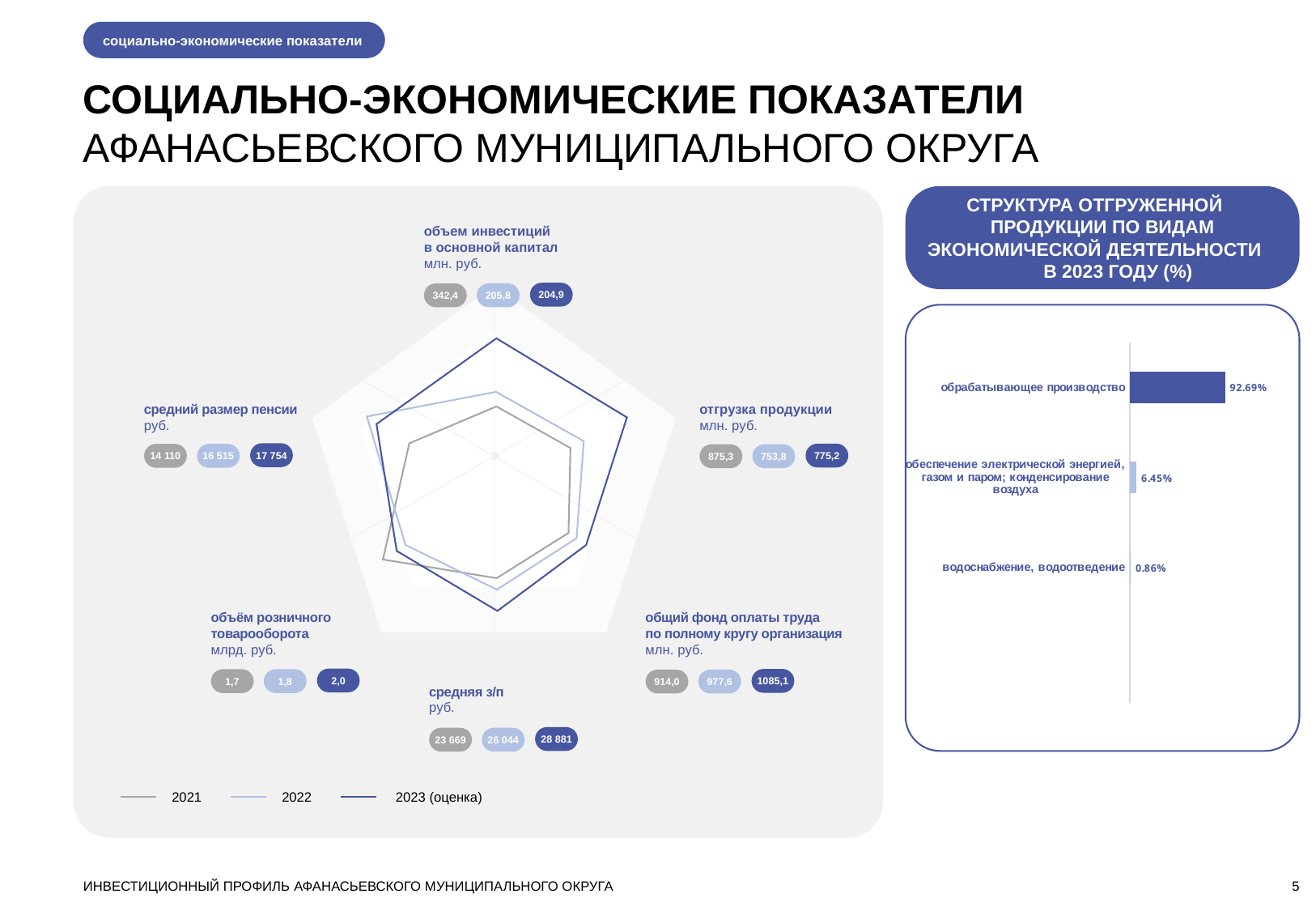
What kind of chart is the chart on the right side of the slide? bar chart In the radar chart on the left, does средняя з/п rise or fall from 2021 to 2023? rises How many categories are shown in the bar chart on the right? 3 In the radar chart on the left, which year has the larger value for отгрузка продукции: 2021 or 2023 (оценка)? 2021 How many series does the legend of the radar chart on the left list? 3 In the radar chart on the left, what is the difference between the 2023 (оценка) and 2022 values of общий фонд оплаты труда по полному кругу организация? 107,5 What kind of chart is the chart on the left side of the slide? radar chart In the bar chart on the right, what is the difference between обрабатывающее производство and обеспечение электрической энергией, газом и паром; конденсирование воздуха? 86.24% In the bar chart on the right, which category has the lowest value? водоснабжение, водоотведение In the bar chart on the right (Структура отгруженной продукции), what is the value for обрабатывающее производство? 92.69% In the radar chart on the left, what is the value of средняя з/п for 2023 (оценка)? 28 881 In the radar chart on the left, what is the value of средний размер пенсии for 2021? 14 110